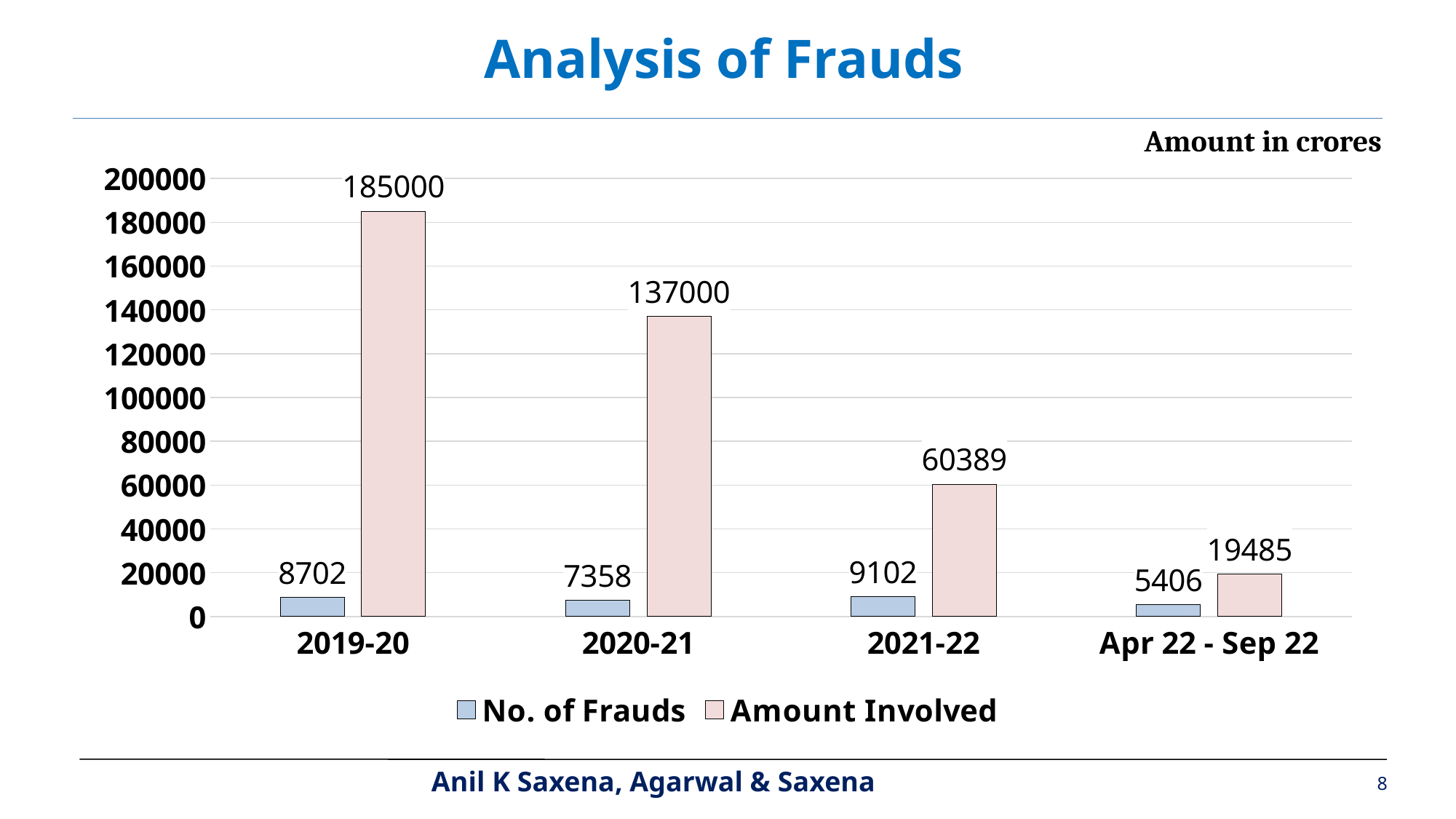
How many periods are shown on the x axis? 4 Which is larger, the No. of Frauds in 2019-20 or in 2020-21? 2019-20 What is the Amount Involved for Apr 22 - Sep 22? 19485 What is the No. of Frauds for 2021-22? 9102 Does the Amount Involved rise or fall across the periods from 2019-20 to Apr 22 - Sep 22? Fall Which period has the lowest No. of Frauds? Apr 22 - Sep 22 Which period has the highest Amount Involved? 2019-20 What is the difference in Amount Involved between 2019-20 and 2020-21? 48000 What kind of chart is shown on the slide? Bar chart What is the title of the chart? Analysis of Frauds What is the Amount Involved for 2019-20? 185000 How many series does the legend list? 2